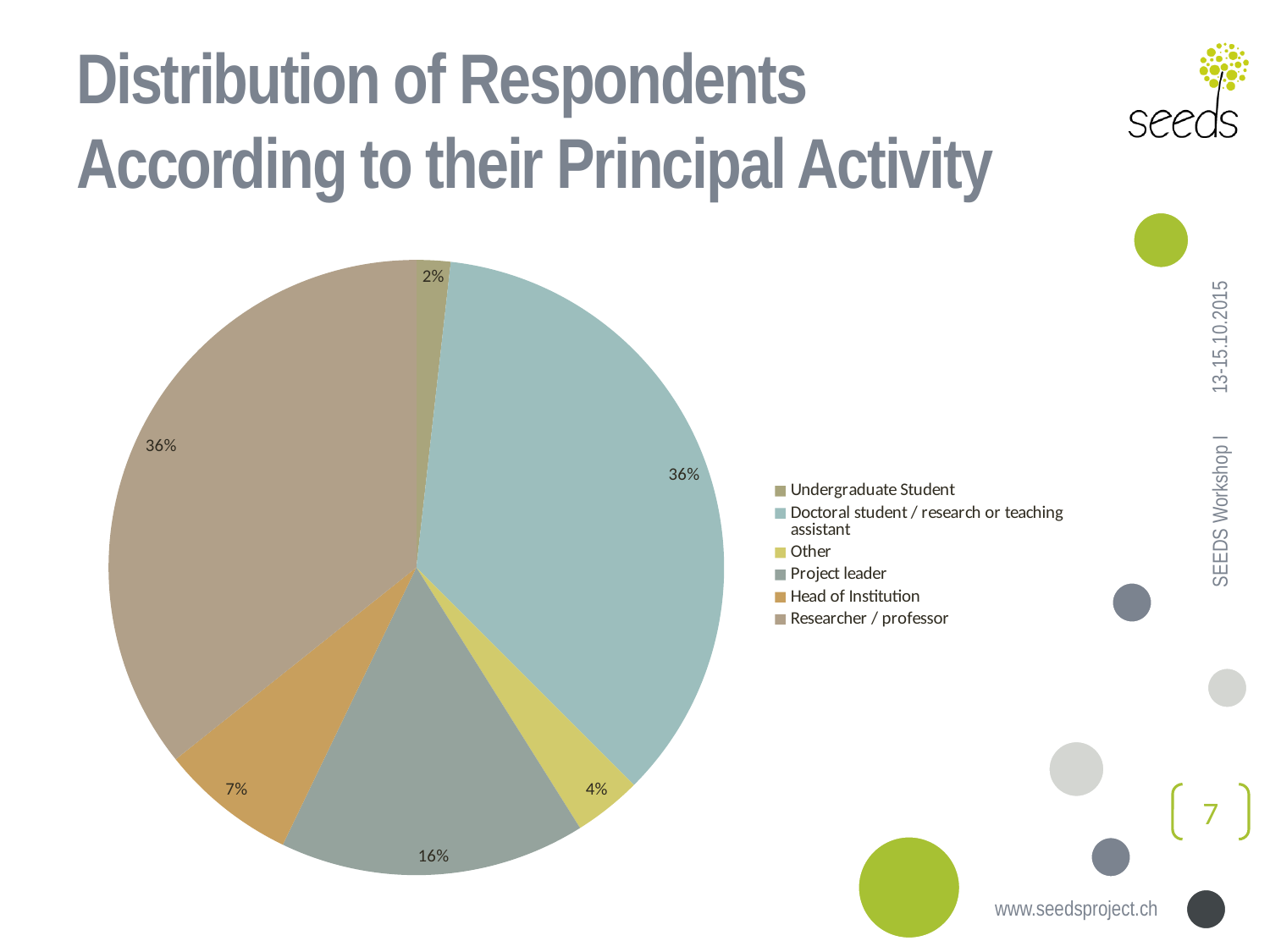
What share of respondents are Doctoral students / research or teaching assistants? 36% Which category has the smallest share of respondents? Undergraduate Student What is the title of the slide containing the chart? Distribution of Respondents According to their Principal Activity What share of respondents are Undergraduate Students? 2% What share of respondents are Heads of Institution? 7% What kind of chart is shown on the slide? pie chart What is the difference between the share for Project leader and the share for Other? 12% Which legend entry is listed first? Undergraduate Student Which is larger: the share for Project leader or the share for Head of Institution? Project leader How many categories does the pie chart show? 6